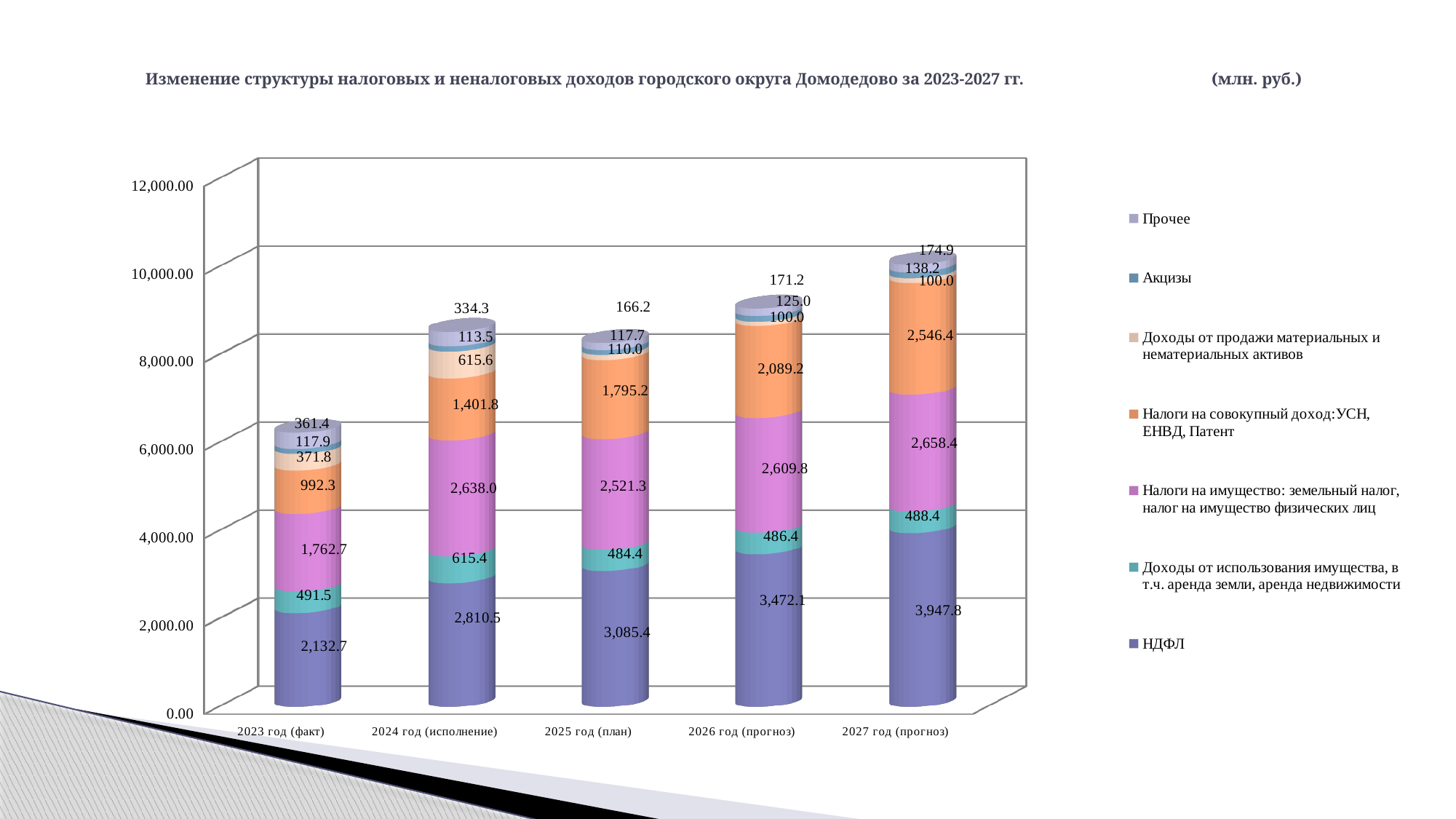
In which year is НДФЛ the lowest? 2023 год (факт) In which year is НДФЛ the highest? 2027 год (прогноз) What is the difference between НДФЛ in 2027 год (прогноз) and in 2023 год (факт)? 1,815.1 What kind of chart is shown on the slide? Stacked bar chart Which year has the larger value for Налоги на совокупный доход: 2024 год (исполнение) or 2025 год (план)? 2025 год (план) What is the value of Прочее for 2023 год (факт)? 361.4 Does НДФЛ rise or fall from 2023 to 2027? Rises What is the value of НДФЛ for 2027 год (прогноз)? 3,947.8 How many year categories are shown on the x axis? 5 How many series does the legend list? 7 What is the value of Налоги на имущество for 2024 год (исполнение)? 2,638.0 What is the value of Доходы от использования имущества for 2026 год (прогноз)? 486.4